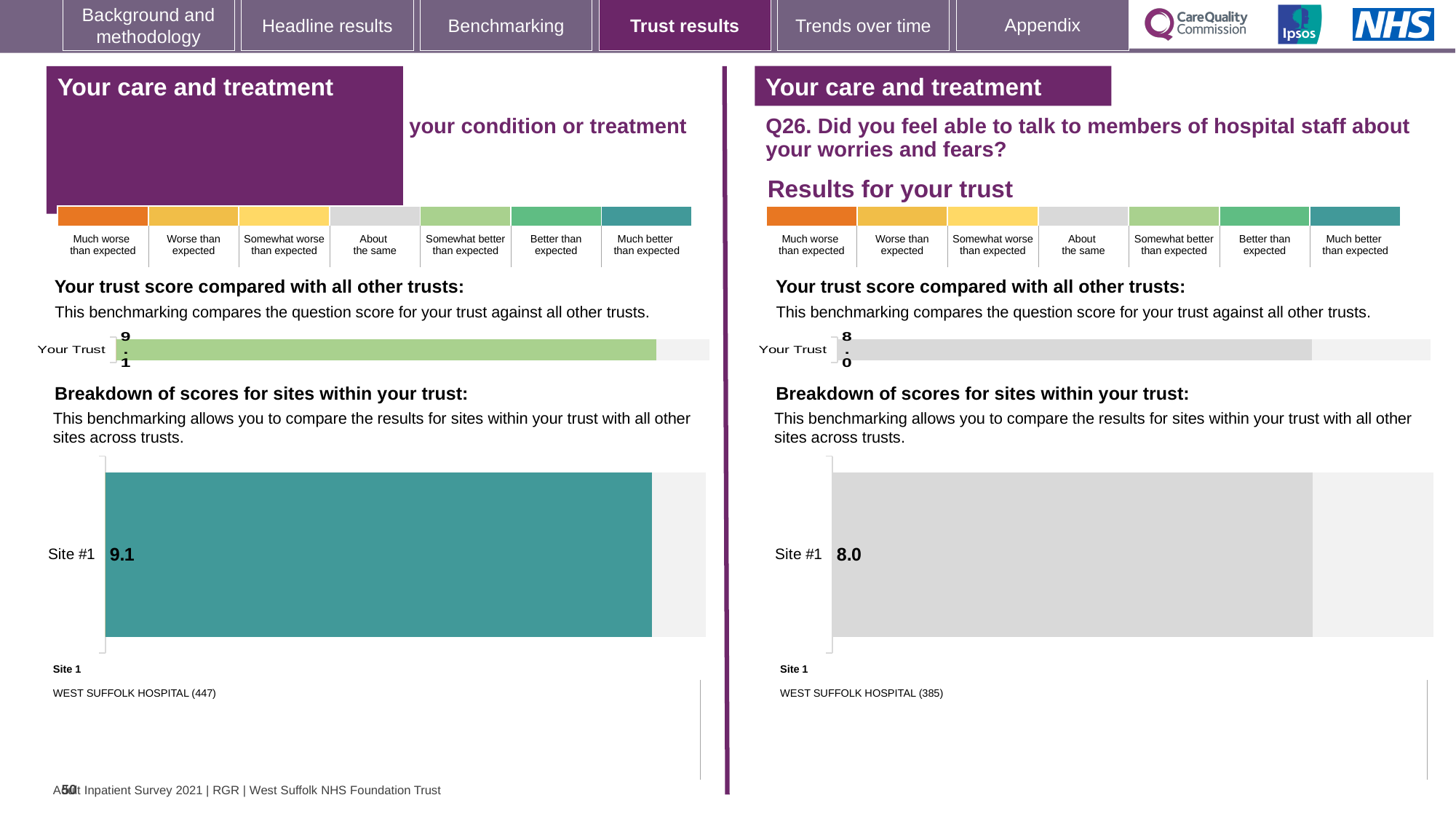
What is the difference between the Site #1 score on the left-hand chart (9.1) and the Site #1 score on the right-hand Q26 chart (8.0)? 1.1 On the left-hand chart (question about your condition or treatment), what is the score shown for Your Trust? 9.1 Which hospital is listed as Site 1 on the left-hand breakdown chart? WEST SUFFOLK HOSPITAL Which is larger: the Your Trust score on the left-hand chart or the Your Trust score on the right-hand Q26 chart? Left-hand chart (9.1) On the right-hand Q26 chart, how many respondents are listed for Site 1 (West Suffolk Hospital)? 385 What kind of chart is used to show the Site #1 score on the right-hand Q26 breakdown? Bar chart How many categories are shown in the benchmark scale above the right-hand Q26 chart (from 'Much worse than expected' to 'Much better than expected')? 7 How many sites are shown in the breakdown chart on the right-hand Q26 section? 1 On the left-hand breakdown chart, what is the score for Site #1? 9.1 What colour is the Site #1 bar on the right-hand Q26 breakdown chart? Grey On the right-hand breakdown chart for Q26, what is the score for Site #1? 8.0 On the right-hand chart for Q26, what is the score shown for Your Trust? 8.0